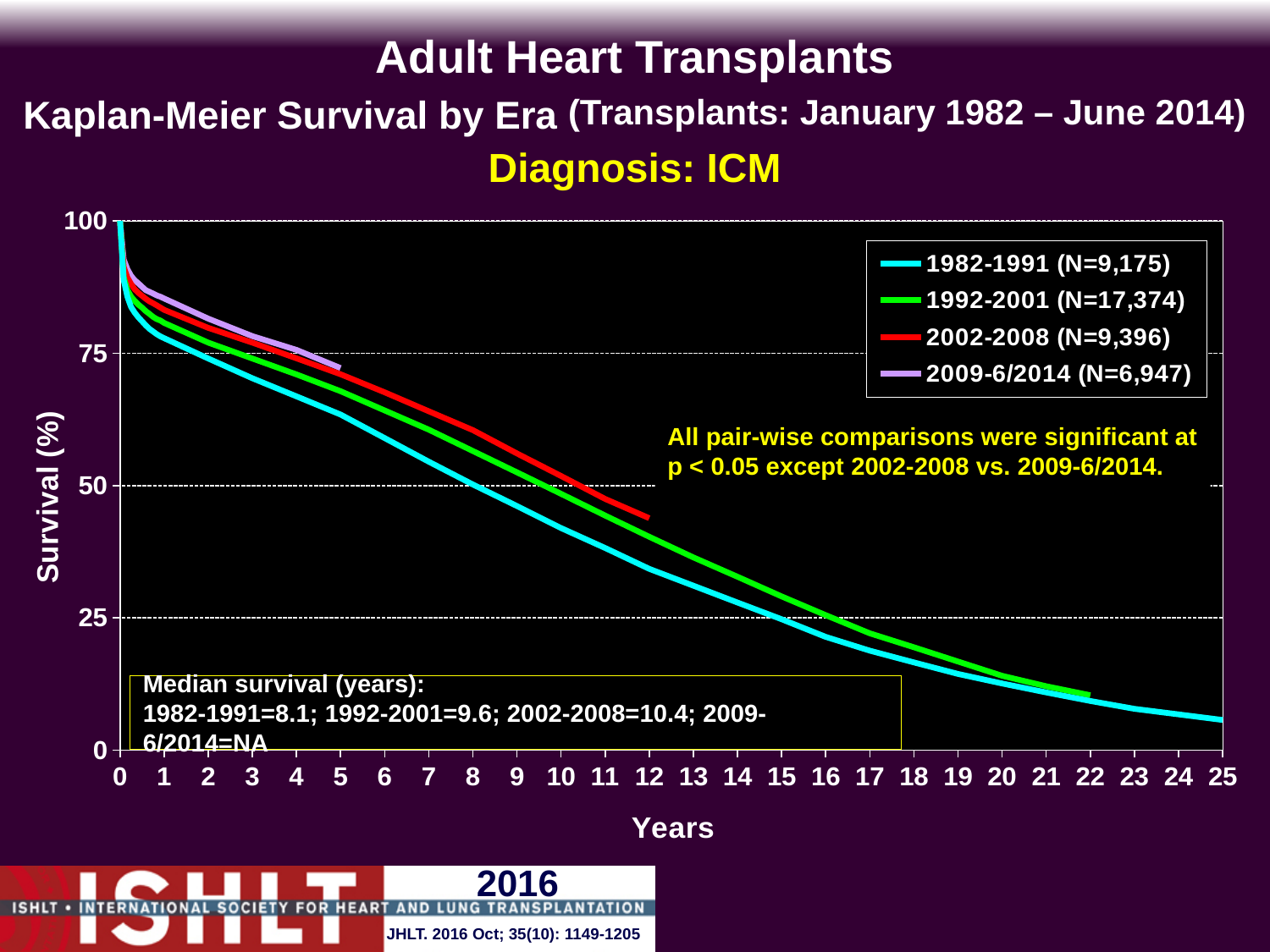
Is the survival for the 1992-2001 era at 5 years greater or less than 50? greater What is the difference in median survival (years) between the 2002-2008 era and the 1982-1991 era? 2.3 At 5 years, which era has higher survival: 1982-1991 or 2002-2008? 2002-2008 Do the survival curves rise or fall as years increase? fall Which era has the smallest number of transplants (N) in the legend? 2009-6/2014 What is the N for the 1992-2001 era shown in the legend? 17,374 What is the median survival in years for the 2002-2008 era? 10.4 What kind of chart is shown on the slide? line chart How many series does the legend list? 4 What is the median survival in years for the 1982-1991 era? 8.1 Which era has the largest number of transplants (N) in the legend? 1992-2001 Is the survival for the 1982-1991 era at 10 years greater or less than 50? less